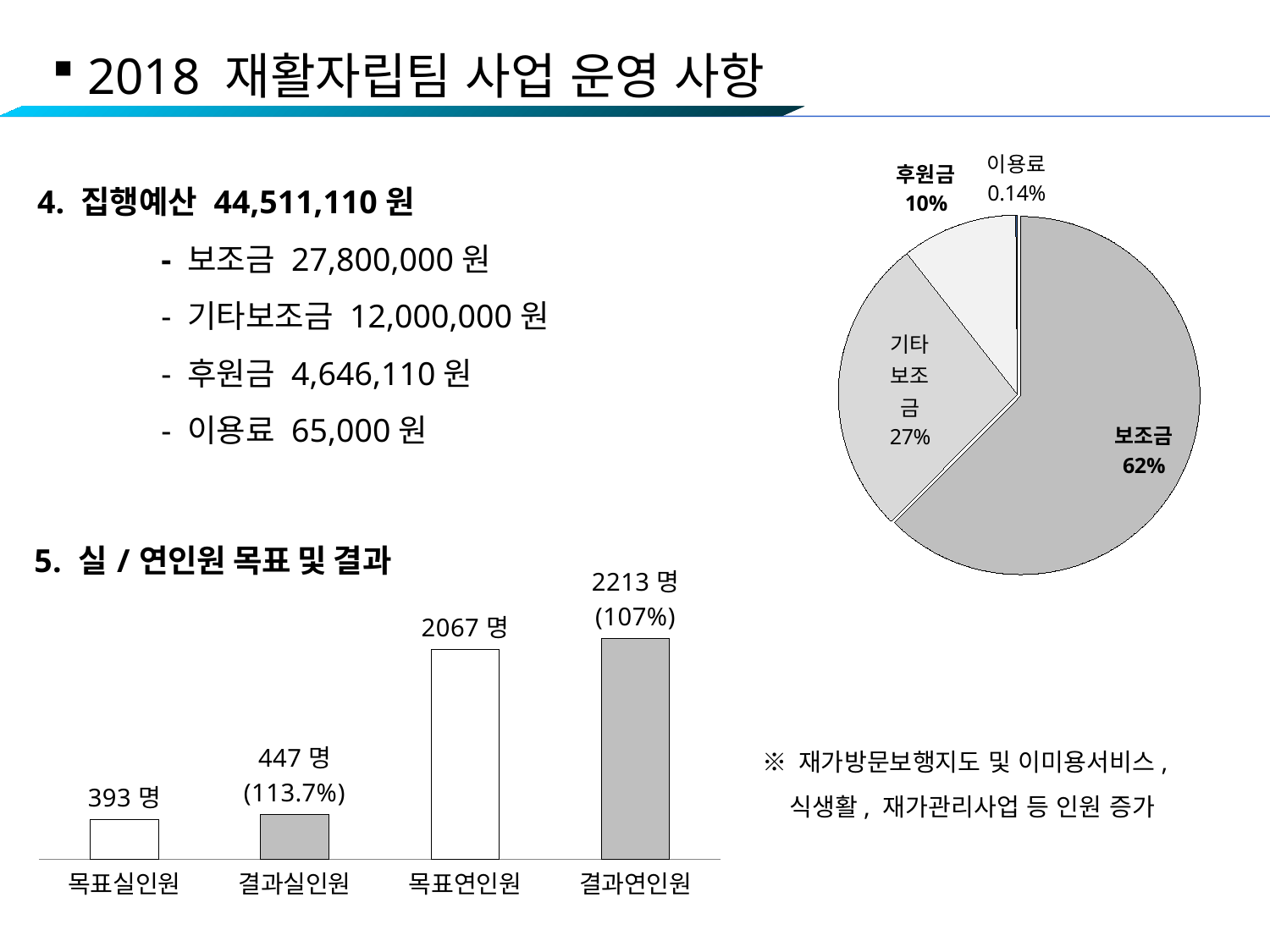
In the pie chart on the right, what share does 보조금 have? 62% In the bar chart at the bottom left, which category has the highest value? 결과연인원 How many slices does the pie chart on the right have? 4 What kind of chart is shown at the bottom left of the slide? Bar chart In the pie chart on the right, what share does 이용료 have? 0.14% In the bar chart at the bottom left, what is the value for 결과연인원? 2213 명 In the pie chart on the right, which slice is the smallest? 이용료 In the bar chart at the bottom left, what is the difference between 결과실인원 and 목표실인원? 54 명 What kind of chart is shown at the top right of the slide? Pie chart In the pie chart on the right, which slice is the largest? 보조금 In the pie chart on the right, what share does 기타보조금 have? 27% In the bar chart at the bottom left, what is the value for 목표실인원? 393 명